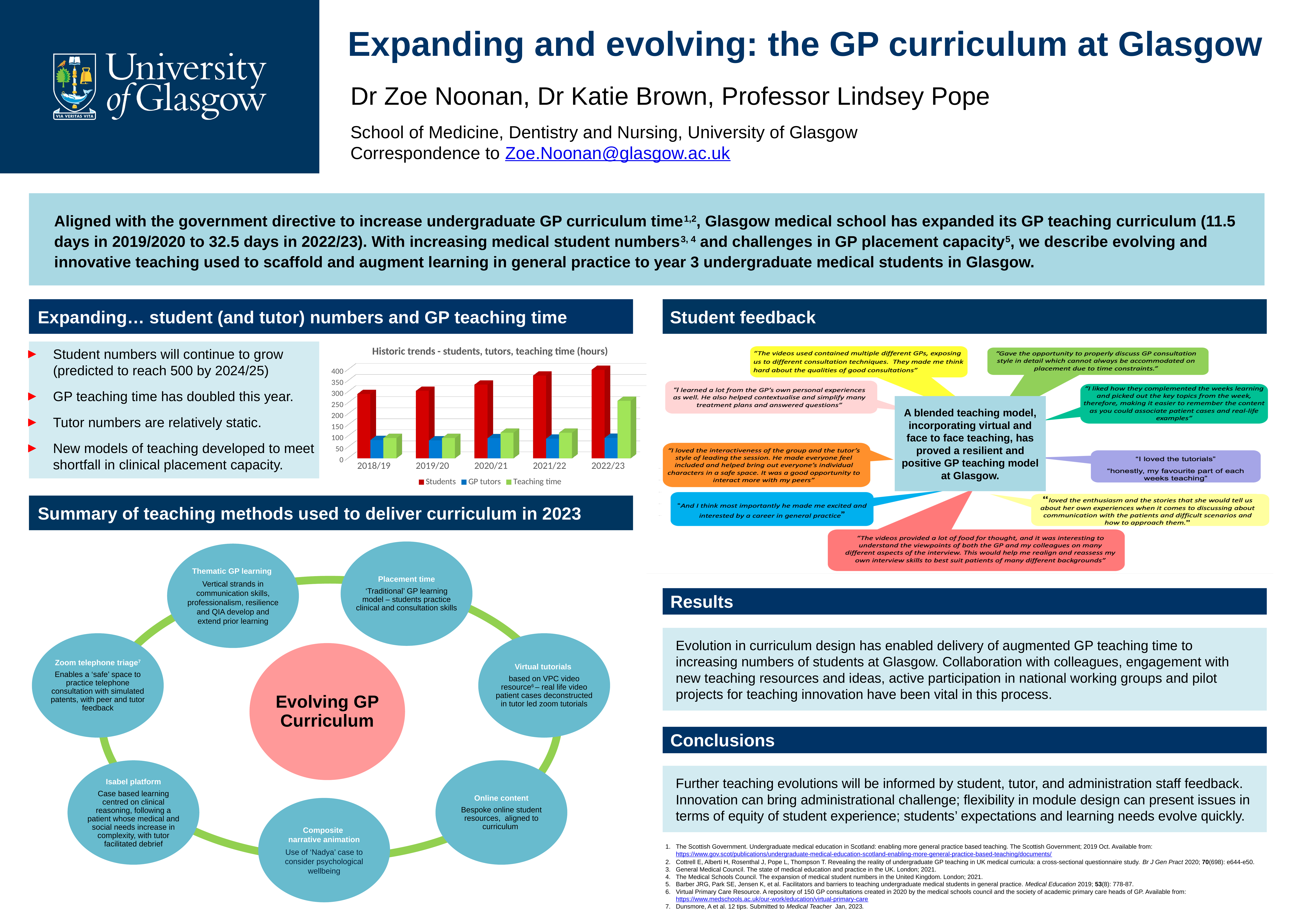
Is the GP tutors value for 2021/22 greater or less than 150? less In which year is the Students bar highest in the chart? 2022/23 How many academic years are shown on the x axis of the chart? 5 Do the Students values rise or fall from 2018/19 to 2022/23? rise What is the title of the chart on the slide? Historic trends - students, tutors, teaching time (hours) What kind of chart is shown under 'Expanding… student (and tutor) numbers and GP teaching time'? bar chart How many series does the chart's legend list? 3 In 2020/21, which is larger: the Students bar or the Teaching time bar? Students In which year is the Students bar lowest in the chart? 2018/19 In which year is the Teaching time bar highest in the chart? 2022/23 Is the Teaching time value for 2022/23 greater or less than 200? greater Is the Students value for 2018/19 greater or less than 250? greater